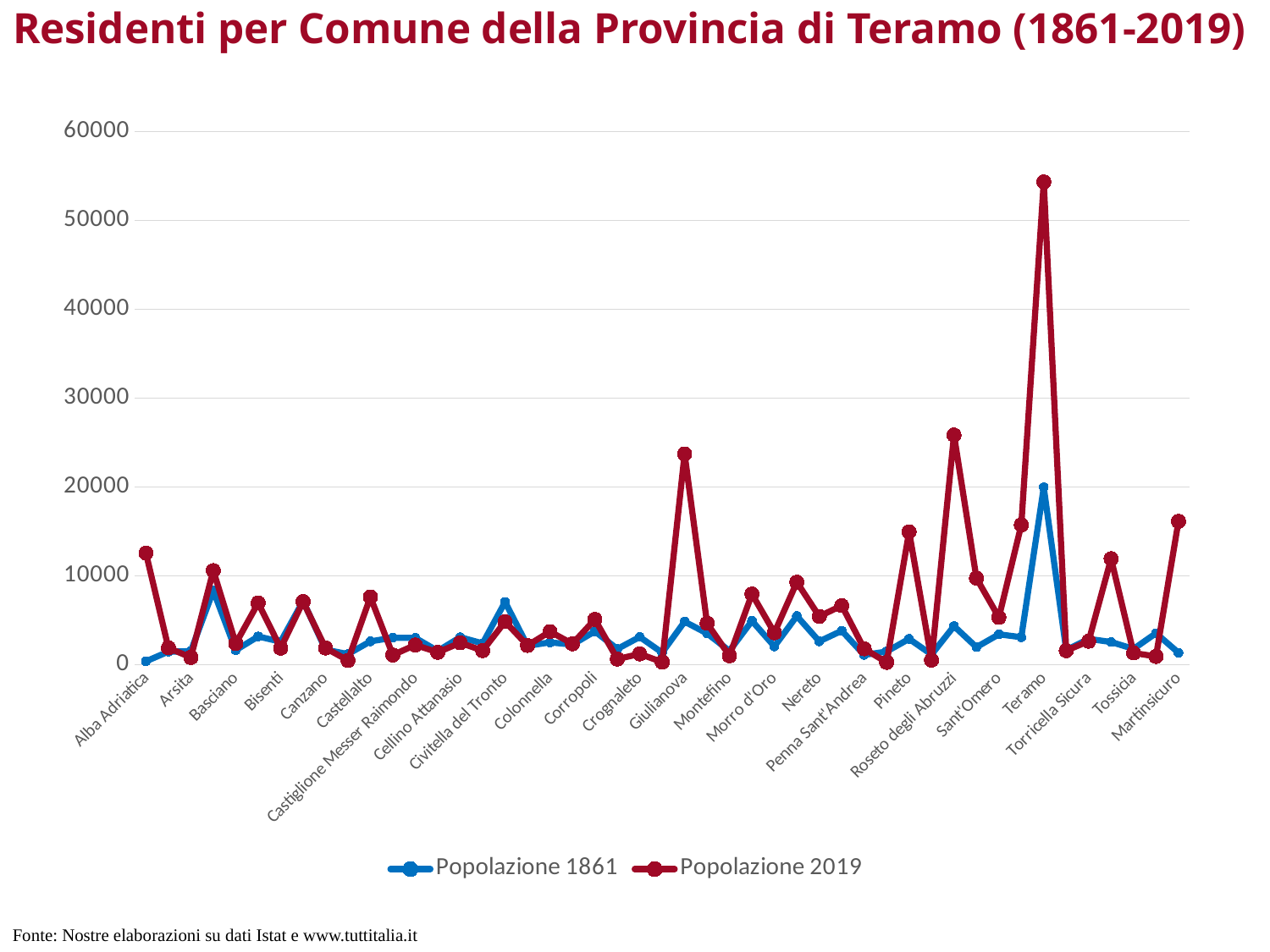
Which comune has the highest value for Popolazione 1861? Teramo Is the Popolazione 2019 value for Alba Adriatica greater or less than 10000? greater For Teramo, which is larger: Popolazione 1861 or Popolazione 2019? Popolazione 2019 For Martinsicuro, which is larger: Popolazione 1861 or Popolazione 2019? Popolazione 2019 Is the Popolazione 2019 value for Giulianova greater or less than 20000? greater Is the Popolazione 2019 value for Teramo greater or less than 50000? greater What kind of chart is shown on the slide? line chart How many series does the legend list? 2 Which comune has the highest value for Popolazione 2019? Teramo What is the title of the chart? Residenti per Comune della Provincia di Teramo (1861-2019)